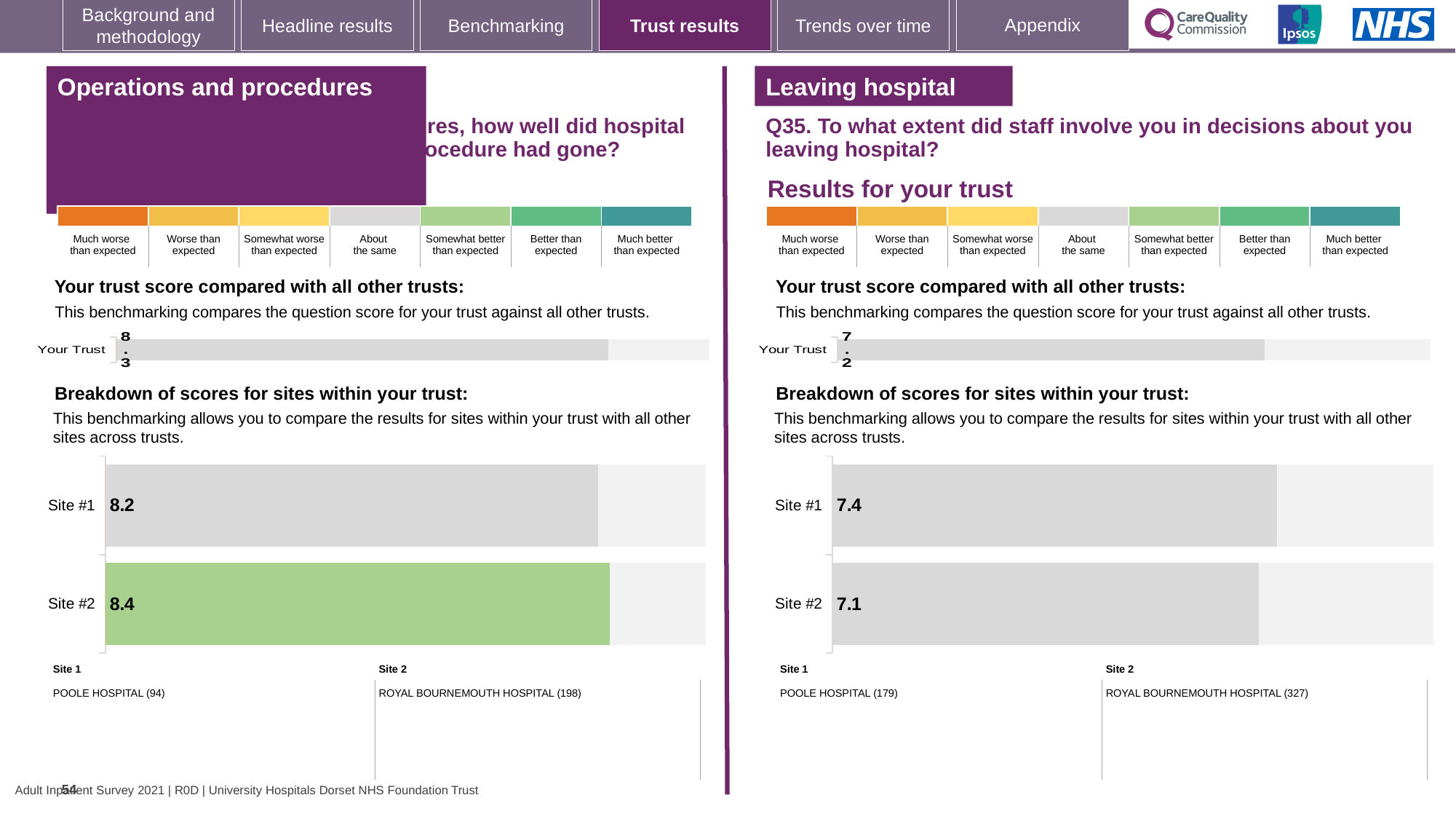
What type of chart is used for the site breakdown in the 'Leaving hospital' section? Bar chart In the 'Leaving hospital' site breakdown chart, which site has the lower score? Site #2 In the 'Leaving hospital' site breakdown chart, what is the score for Site #2? 7.1 In the 'Operations and procedures' site breakdown chart, which site has the higher score? Site #2 In the 'Operations and procedures' site breakdown chart, which site's bar is coloured green? Site #2 In the 'Leaving hospital' site breakdown chart, what is the score for Site #1? 7.4 In the 'Operations and procedures' site breakdown chart, what is the score for Site #2? 8.4 In the 'Operations and procedures' section, what is the score shown for Your Trust? 8.3 In the 'Leaving hospital' site breakdown chart, what is the difference between the Site #1 and Site #2 scores? 0.3 In the 'Leaving hospital' section, what is the score shown for Your Trust? 7.2 In the 'Operations and procedures' site breakdown chart, how many sites are shown? 2 In the 'Operations and procedures' site breakdown chart, what is the score for Site #1? 8.2